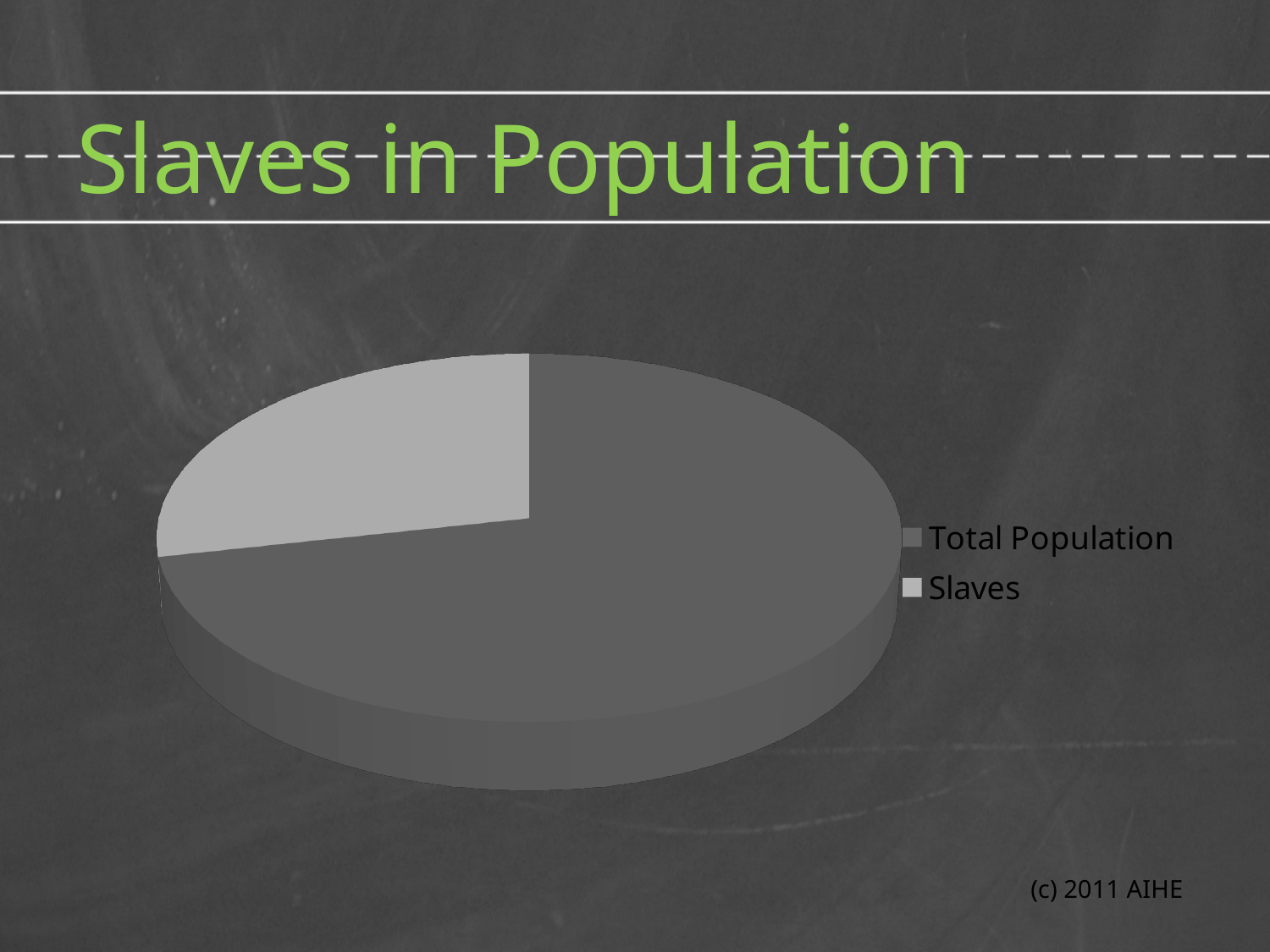
Is the Slaves slice larger or smaller than the Total Population slice? smaller Which slice of the pie chart is the smallest? Slaves How many slices does the pie chart have? 2 Which slice is larger in the pie chart, Total Population or Slaves? Total Population What is the title of the slide containing the pie chart? Slaves in Population Which slice of the pie chart is the largest? Total Population What kind of chart is shown on the slide? pie chart How many entries does the legend of the pie chart list? 2 What are the two legend entries of the pie chart? Total Population, Slaves